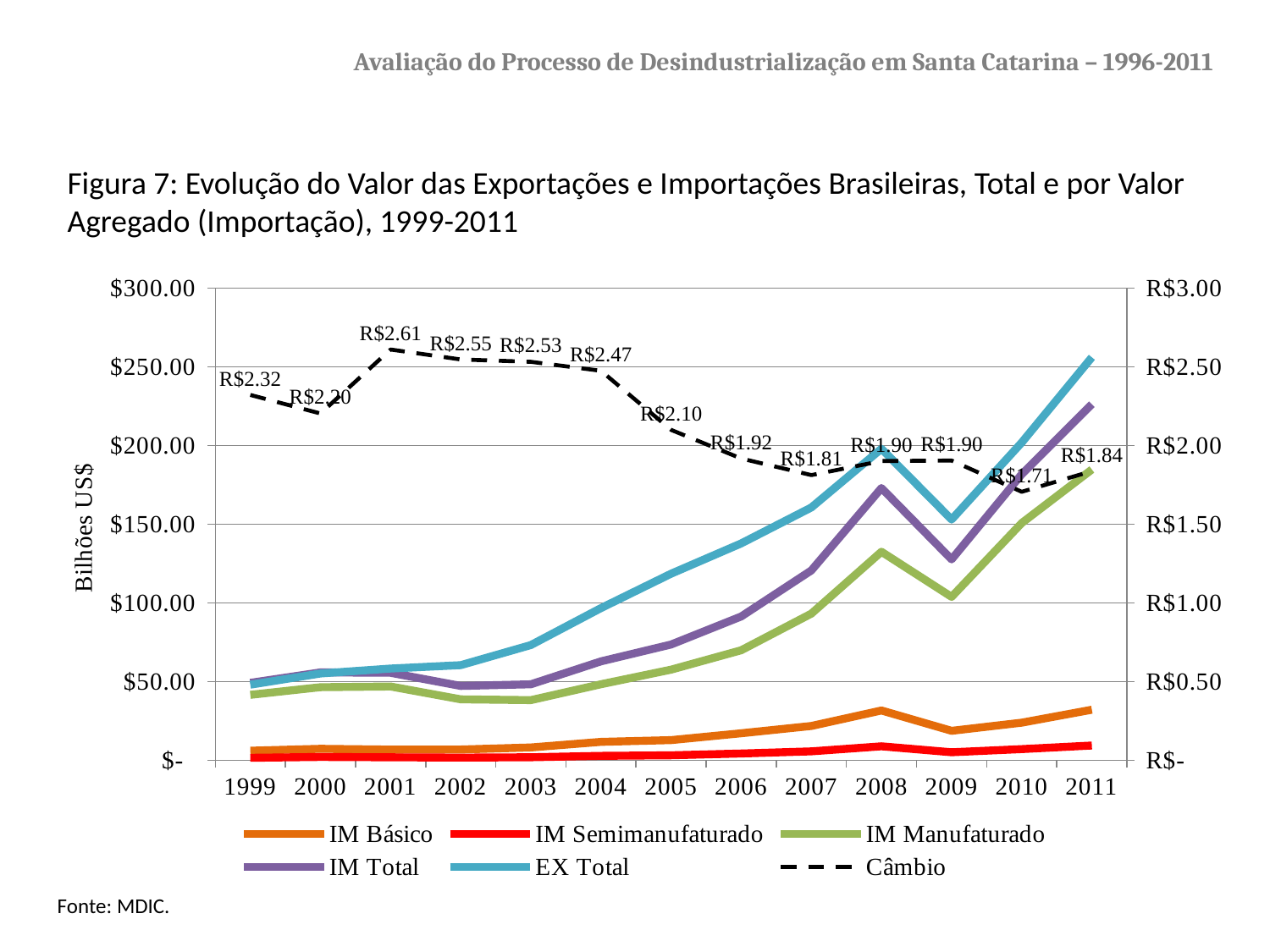
How many years are plotted along the x axis? 13 Is the value for EX Total in 2011 greater or less than $250.00? greater What is the Câmbio value shown for 2010? R$1.71 What is the label on the left vertical axis? Bilhões US$ What kind of chart is shown on the slide? Line chart In which year is the Câmbio series at its highest? 2001 What is the Câmbio value shown for 2001? R$2.61 What is the difference between the Câmbio value in 1999 and in 2011? R$0.48 How many series does the legend list? 6 Is the value for IM Manufaturado in 2009 greater or less than $150.00? less Which is larger, the Câmbio value in 2002 or in 2005? 2002 In which year is the Câmbio series at its lowest? 2010